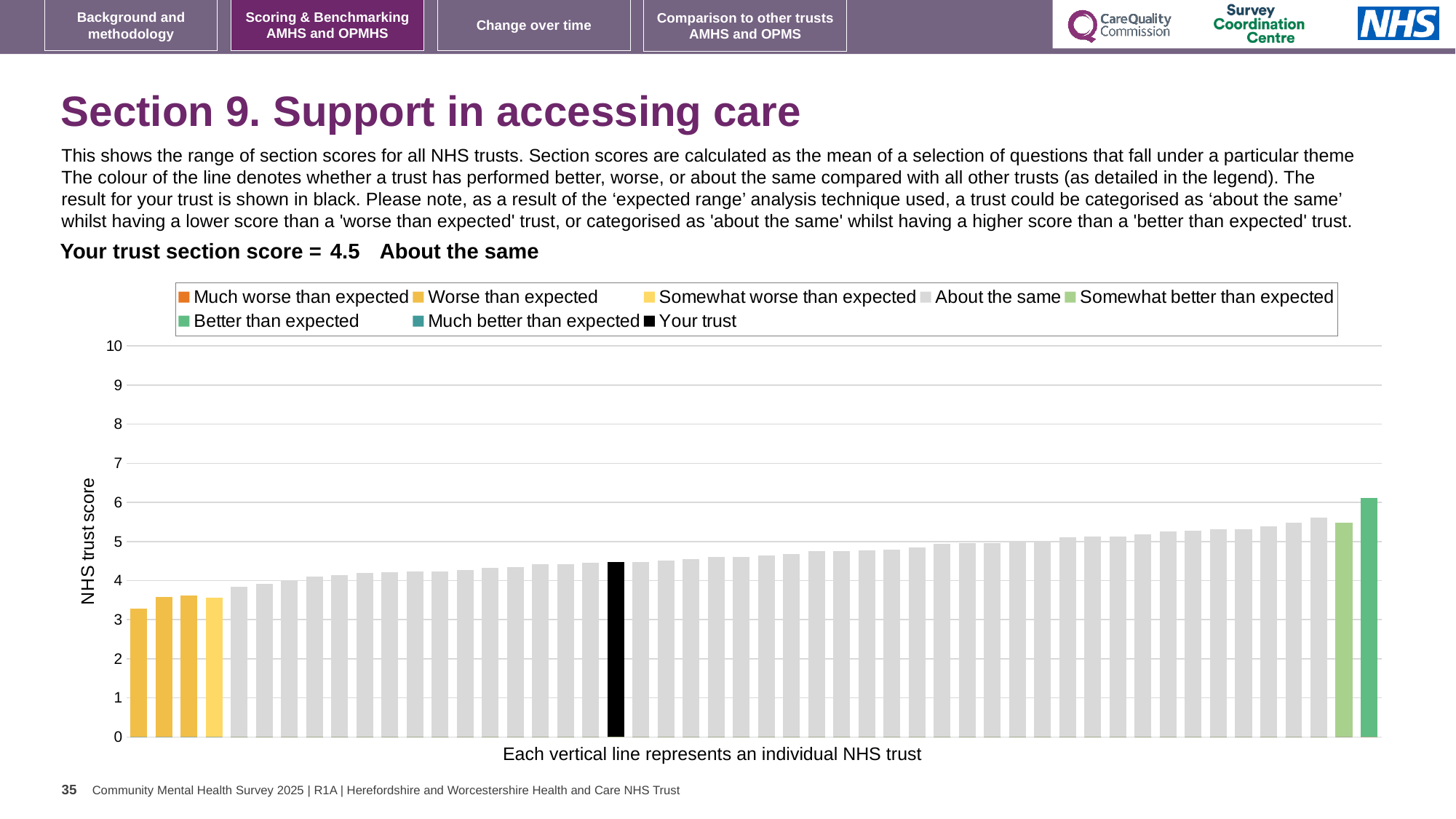
How many entries does the chart legend list? 8 How many bars are coloured yellow? 4 What is the label on the vertical axis? NHS trust score Is the value for your trust greater or less than 4? greater Is the value of the tallest bar greater or less than 5? greater Do the bar values rise or fall from left to right along the x axis? rise Which is larger, the score for your trust (black bar) or the score of the rightmost bar? the rightmost bar What kind of chart is shown on the slide? bar chart Which category is your trust placed in according to the slide? About the same Is the value for your trust greater or less than 5? less What is the section score for your trust? 4.5